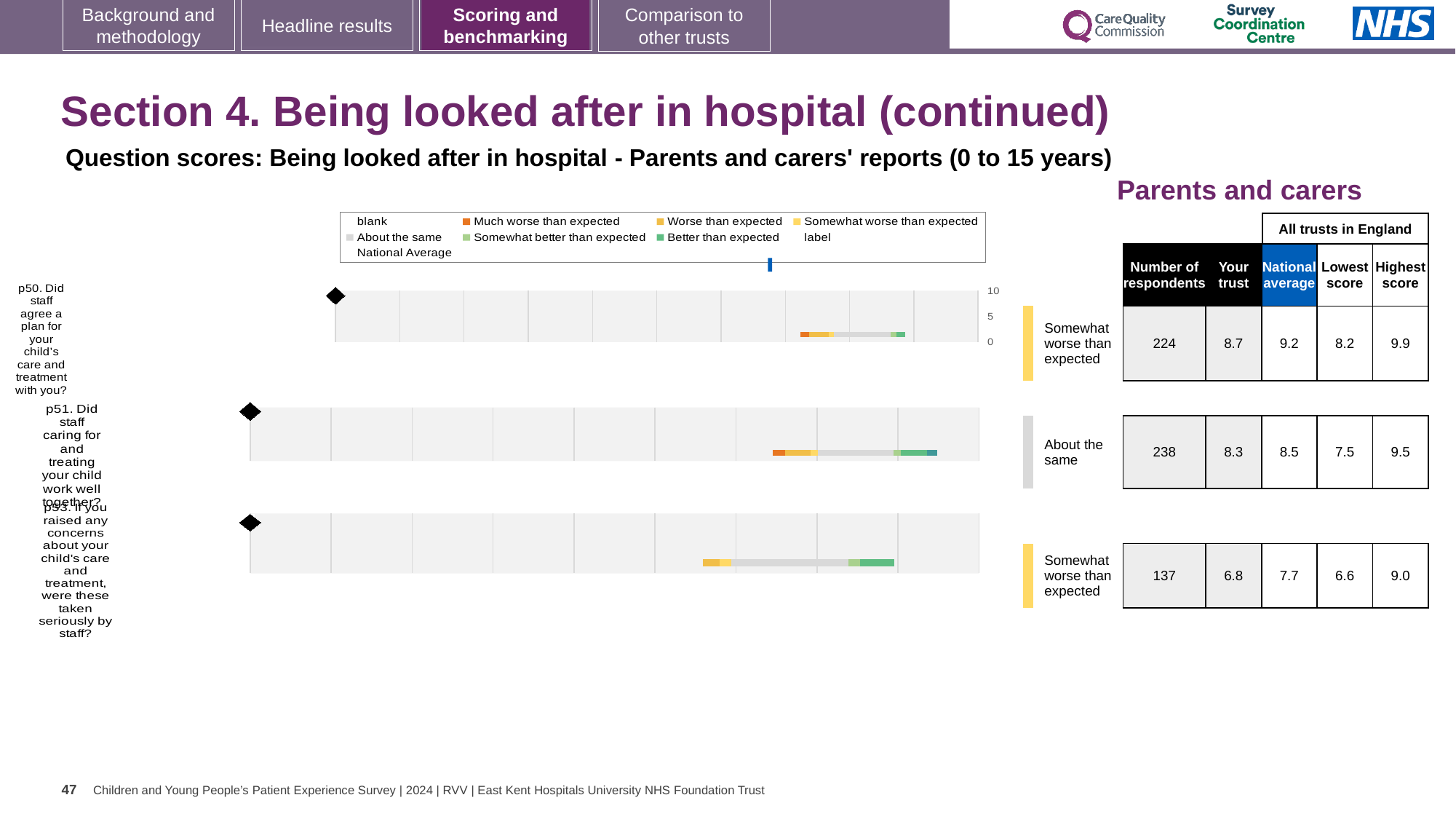
Which of the three questions has the fewest respondents? p53 What kind of chart is used to show the question scores on this slide? bar chart How many questions (p50, p51, p53) are plotted on the slide? 3 For question p51 (Did staff caring for and treating your child work well together?), how many respondents are there? 238 For question p53, what is the lowest score among all trusts in England? 6.6 For question p53 (If you raised any concerns about your child's care and treatment, were these taken seriously by staff?), what is the highest score among all trusts in England? 9.0 For question p50, what is the difference between the national average and the 'Your trust' score? 0.5 For question p50 (Did staff agree a plan for your child's care and treatment with you?), what is the 'Your trust' score? 8.7 For question p50, what is the national average score? 9.2 Which of the three questions has the highest 'Your trust' score? p50 For question p51, which is larger: the 'Your trust' score or the national average? National average For question p53, what is the difference between the highest score and the lowest score? 2.4